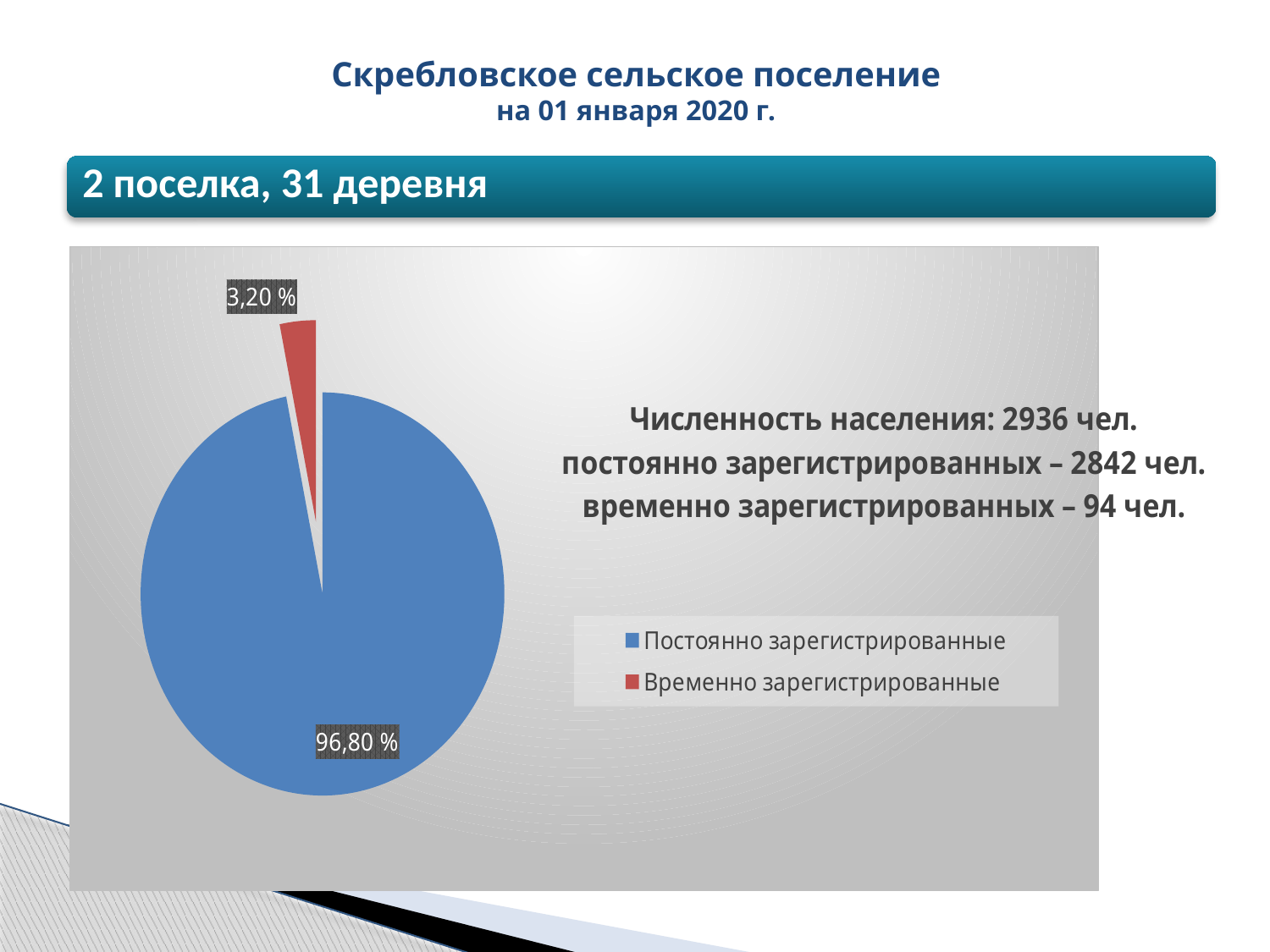
How many entries does the legend of the pie chart list? 2 Which slice of the pie chart is the largest? Постоянно зарегистрированные How many slices does the pie chart have? 2 What kind of chart is shown on the slide? pie chart What share of the pie does the slice "Временно зарегистрированные" take? 3,20 % What colour is the slice for "Постоянно зарегистрированные" in the pie chart? blue Which slice of the pie chart is the smallest? Временно зарегистрированные What share of the pie does the slice "Постоянно зарегистрированные" take? 96,80 % What is the difference in percentage points between the "Постоянно зарегистрированные" slice and the "Временно зарегистрированные" slice? 93,60 % What colour is the slice for "Временно зарегистрированные" in the pie chart? red Which is larger: the share for "Постоянно зарегистрированные" or the share for "Временно зарегистрированные"? Постоянно зарегистрированные